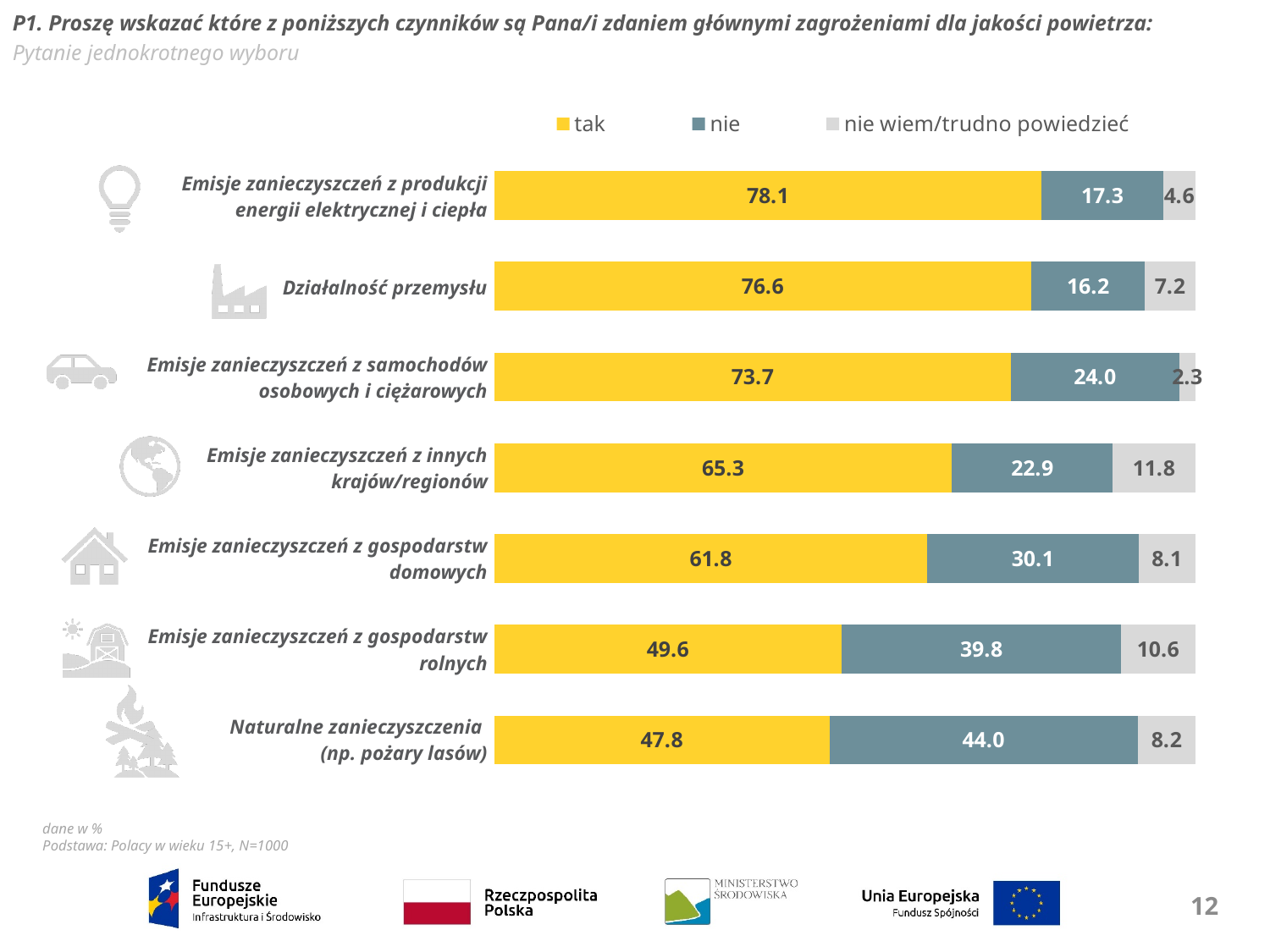
What is the 'tak' value for 'Działalność przemysłu'? 76.6 What is the difference between the 'tak' values for 'Emisje zanieczyszczeń z produkcji energii elektrycznej i ciepła' and 'Naturalne zanieczyszczenia (np. pożary lasów)'? 30.3 Which category has the highest 'tak' value? Emisje zanieczyszczeń z produkcji energii elektrycznej i ciepła Which category has the lowest 'tak' value? Naturalne zanieczyszczenia (np. pożary lasów) How many categories are shown in the chart? 7 Which category has the highest 'nie' value? Naturalne zanieczyszczenia (np. pożary lasów) How many series does the legend list? 3 Which is larger: the 'nie' value for 'Emisje zanieczyszczeń z samochodów osobowych i ciężarowych' or the 'nie' value for 'Emisje zanieczyszczeń z innych krajów/regionów'? Emisje zanieczyszczeń z samochodów osobowych i ciężarowych What kind of chart is shown on the slide? Stacked bar chart What is the total of the stacked bar for 'Emisje zanieczyszczeń z gospodarstw rolnych'? 100.0 What is the 'nie' value for 'Emisje zanieczyszczeń z gospodarstw domowych'? 30.1 What is the 'nie wiem/trudno powiedzieć' value for 'Emisje zanieczyszczeń z innych krajów/regionów'? 11.8